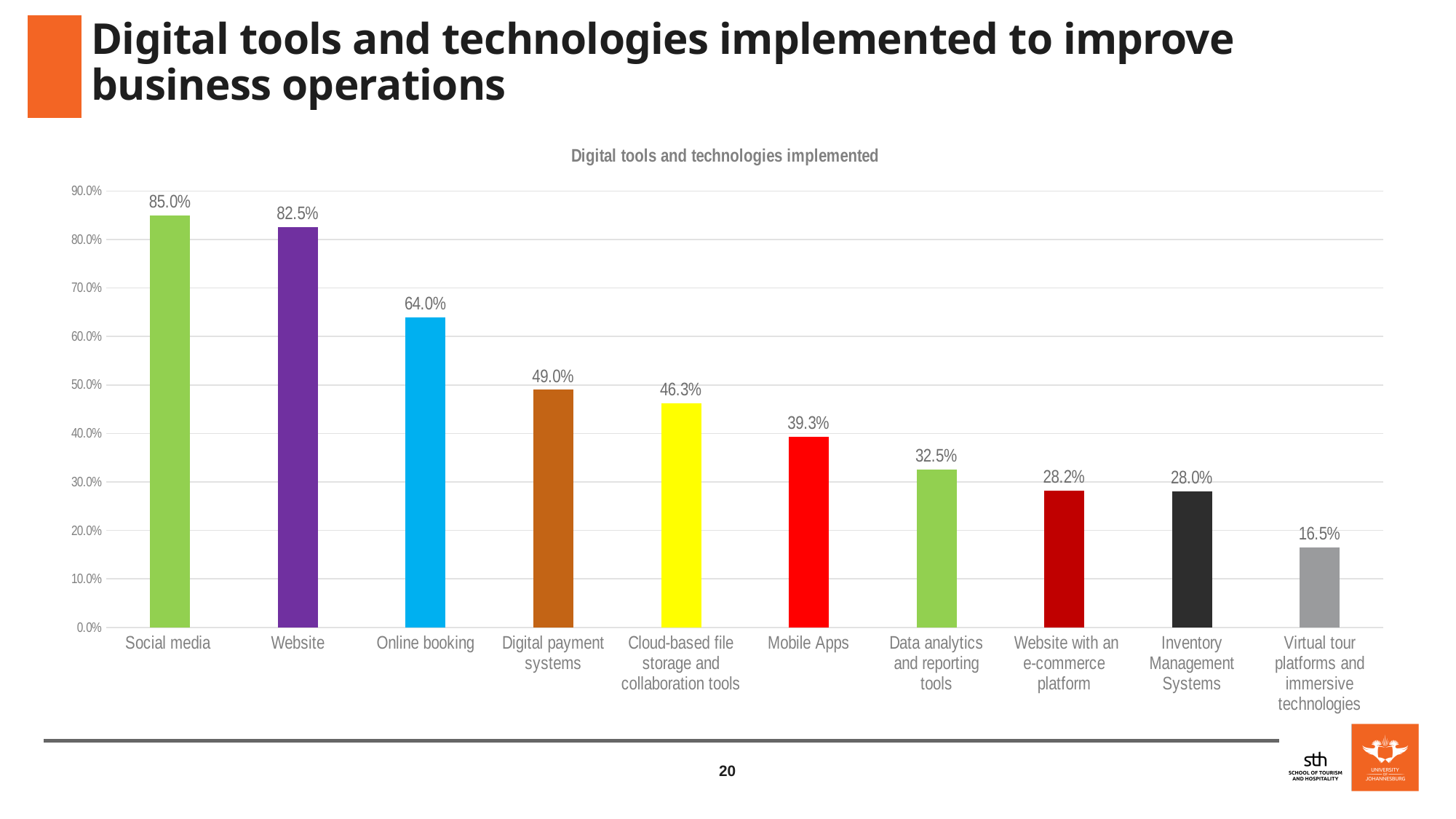
What is the value for Inventory Management Systems? 28.0% What is the value for Cloud-based file storage and collaboration tools? 46.3% What is the difference between the values for Website and Online booking? 18.5% Which category has the highest value? Social media What is the title of the chart? Digital tools and technologies implemented Which category has the lowest value? Virtual tour platforms and immersive technologies Is the value for Digital payment systems greater or less than 40.0%? greater How many categories are shown in the chart? 10 Do the values rise or fall from left to right along the x axis? Fall What is the value for Social media? 85.0% What kind of chart is shown on the slide? Bar chart Which is larger, the value for Mobile Apps or the value for Data analytics and reporting tools? Mobile Apps